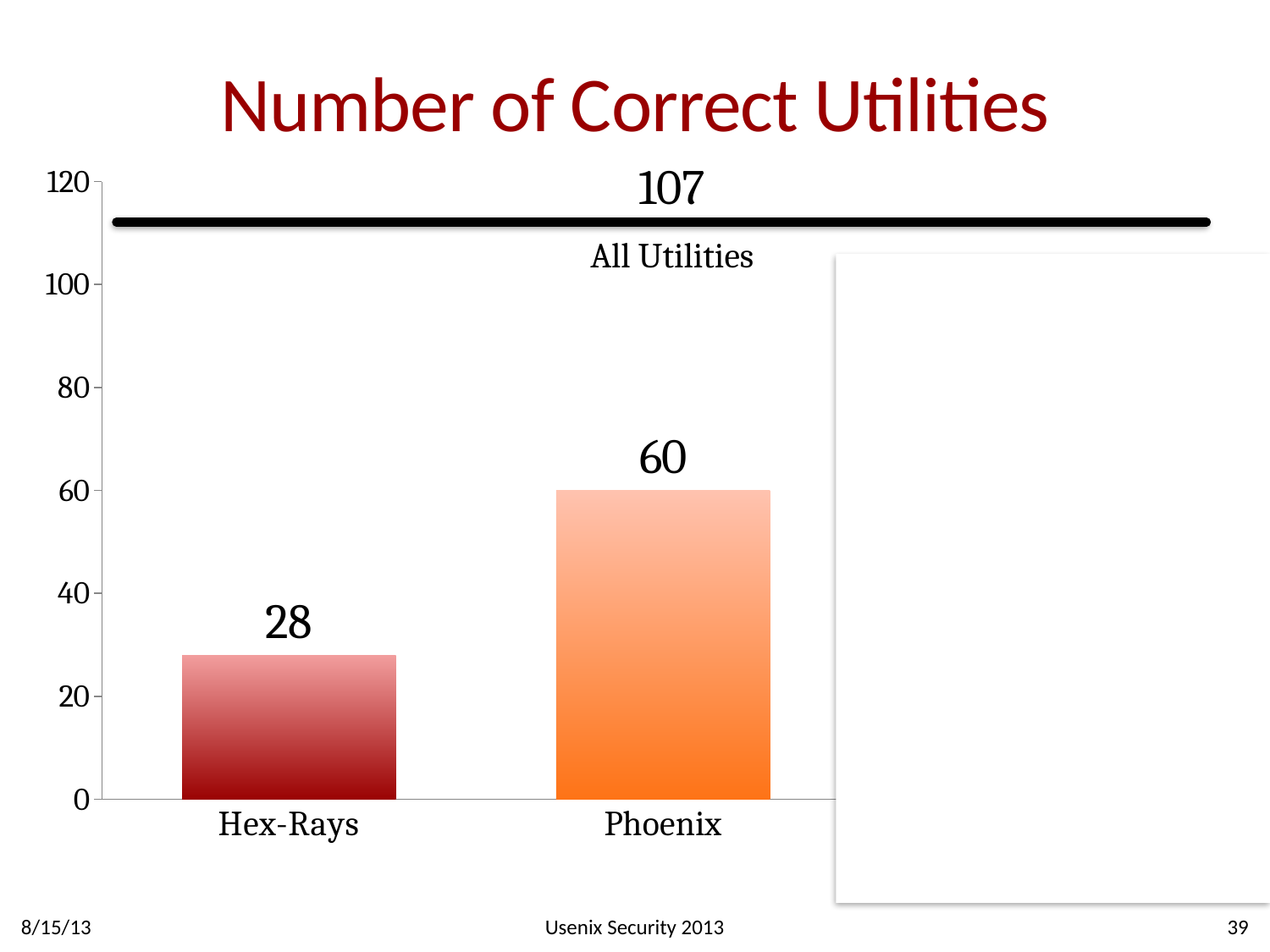
What is the value for Hex-Rays? 28 What is the title of the chart? Number of Correct Utilities How many more utilities are in All Utilities (107) than Phoenix got correct? 47 Which of the two bars, Hex-Rays or Phoenix, is higher? Phoenix What is the value for Phoenix? 60 Which bar is the lowest? Hex-Rays Is the value for Hex-Rays greater or less than 40? less What kind of chart is shown on the slide? bar chart What is the highest value shown on the vertical axis? 120 What is the difference between the Phoenix value and the Hex-Rays value? 32 Is the value for Phoenix greater or less than 40? greater What value does the horizontal line labelled All Utilities mark? 107